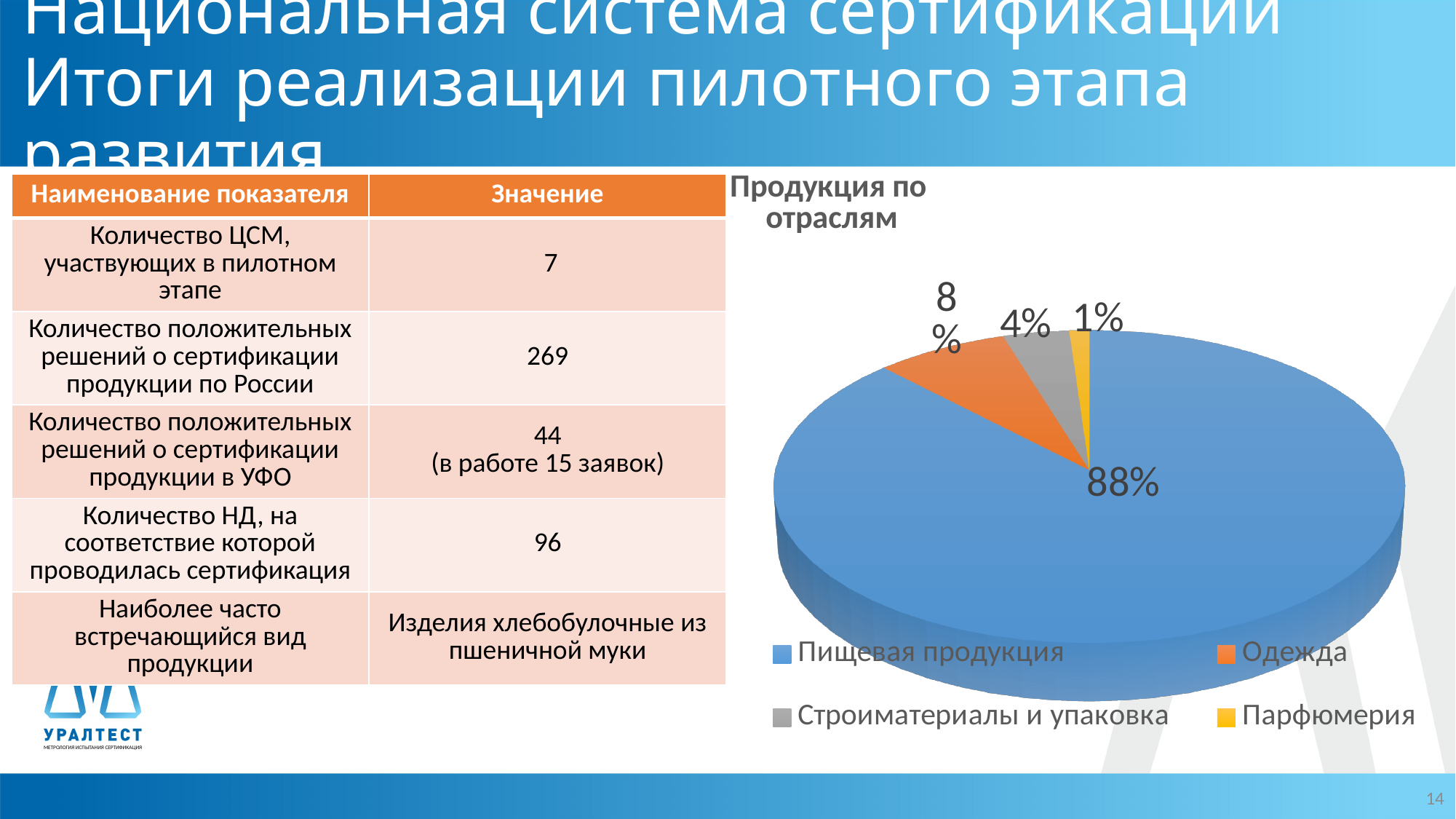
What kind of chart is shown on the slide? Pie chart What colour is the slice for Пищевая продукция? Blue How many categories does the legend list? 4 What share of the pie does Строиматериалы и упаковка have? 4% What is the title of the chart? Продукция по отраслям What share of the pie does Пищевая продукция have? 88% What share of the pie does Одежда have? 8% What is the difference in percentage points between Одежда and Строиматериалы и упаковка? 4 Which category has the smallest slice of the pie? Парфюмерия Which category has the largest slice of the pie? Пищевая продукция Which is larger, the share for Одежда or the share for Парфюмерия? Одежда